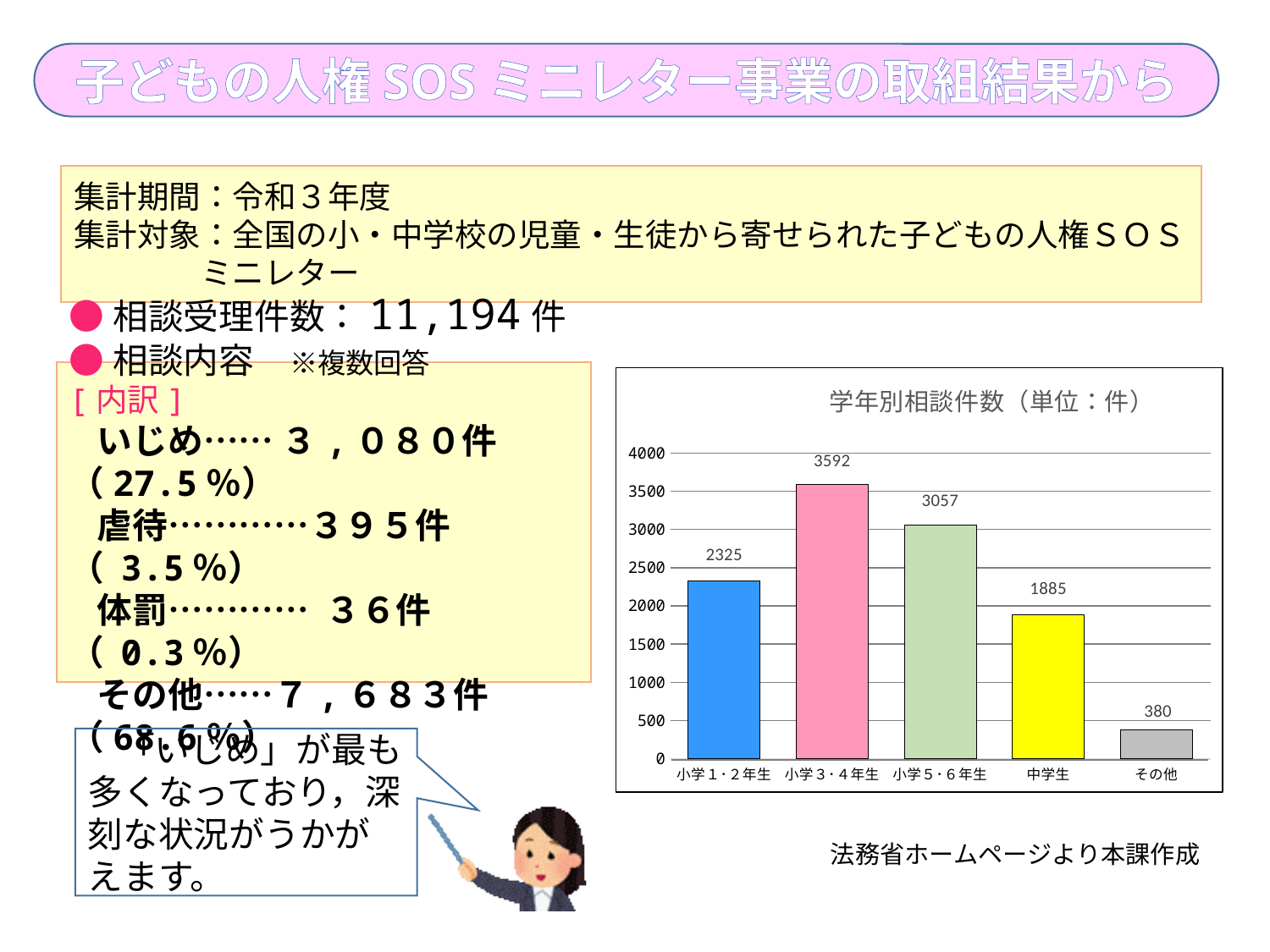
What kind of chart is shown on the slide? bar chart What is the difference between the values for 小学３・４年生 and 小学５・６年生? 535 Is the value for 小学１・２年生 greater or less than 2500? less What is the value for 中学生 in the chart? 1885 What is the difference between the values for 小学１・２年生 and 中学生? 440 Which category has the lowest value in the chart? その他 What is the value for その他 in the chart? 380 How many categories are shown in the chart? 5 What is the value for 小学３・４年生 in the chart? 3592 What is the title of the chart? 学年別相談件数（単位：件） Which category has the highest value in the chart? 小学３・４年生 Which is larger, the value for 小学１・２年生 or the value for 小学５・６年生? 小学５・６年生